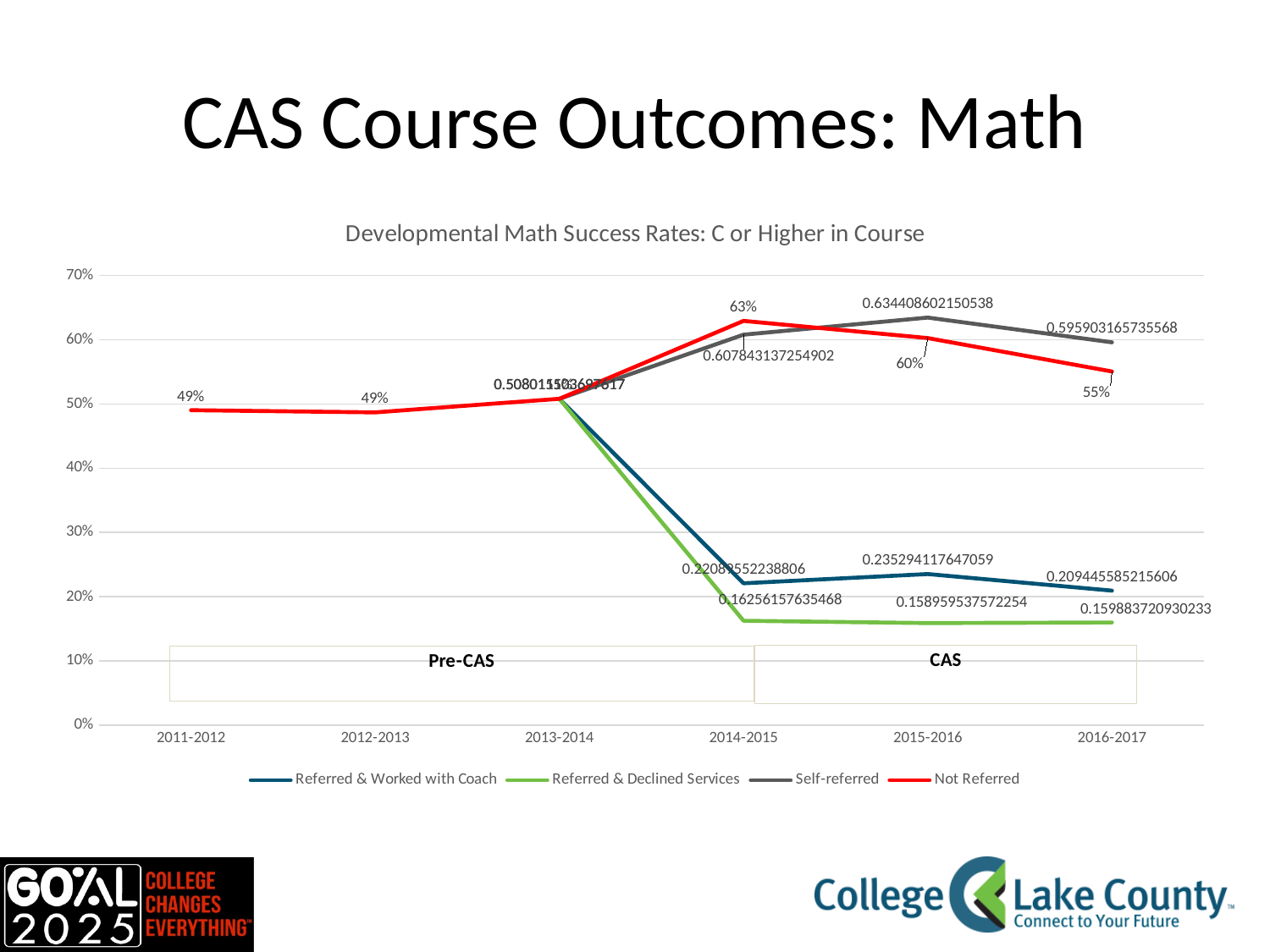
What is the Referred & Declined Services value for 2015-2016? 0.158959537572254 What is the difference between the Not Referred rates for 2014-2015 and 2016-2017? 8% What kind of chart is shown on the slide? line chart What is the Self-referred value for 2015-2016? 0.634408602150538 What is the Not Referred success rate for 2011-2012? 49% How many series does the legend list? 4 In 2016-2017, which is higher: Self-referred or Not Referred? Self-referred In which year is the Not Referred success rate highest? 2014-2015 Is the Referred & Declined Services value for 2014-2015 greater or less than 20%? less What is the Referred & Worked with Coach value for 2016-2017? 0.209445585215606 How many academic years are shown on the x axis? 6 What is the Not Referred success rate for 2014-2015? 63%